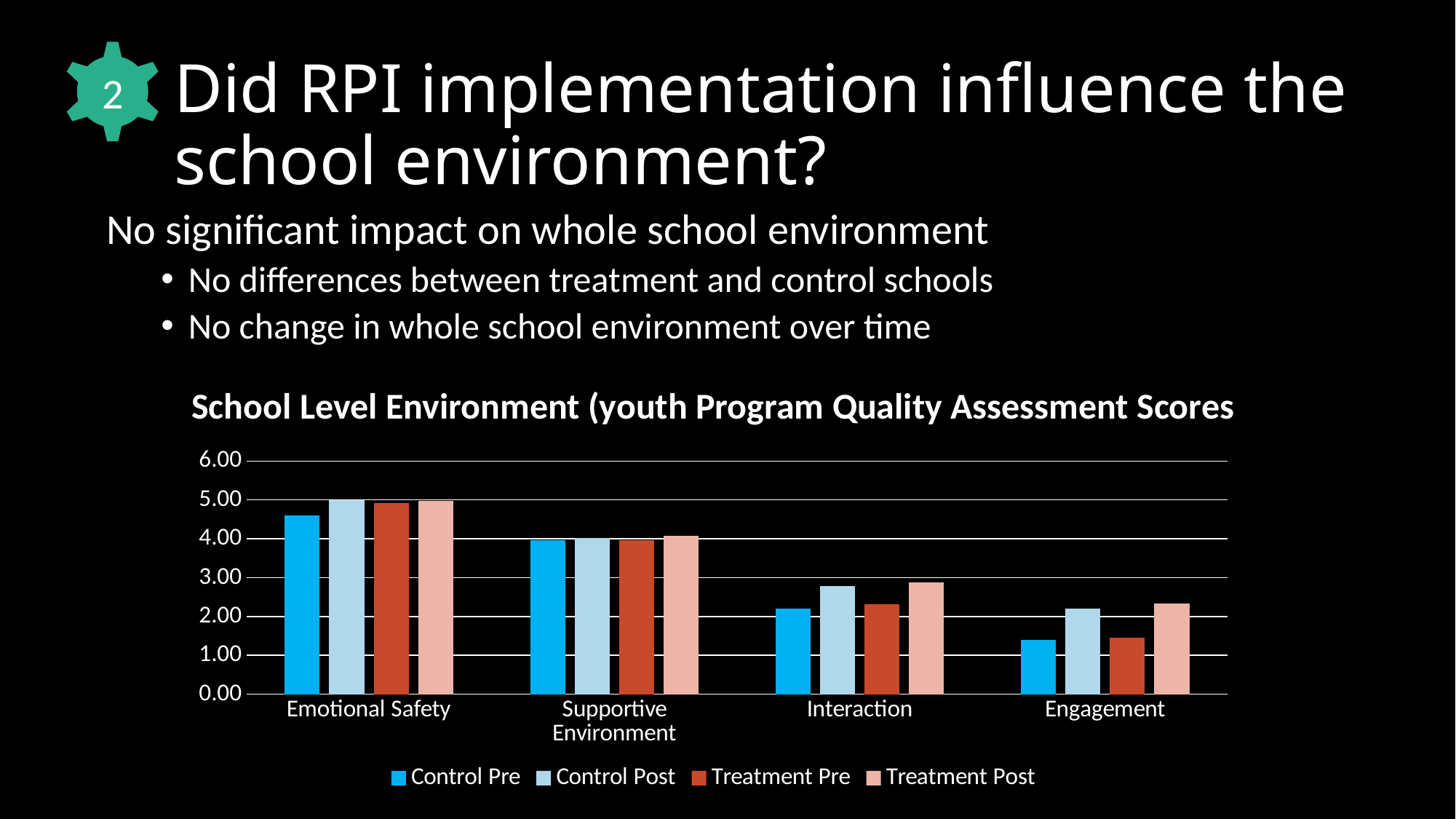
How many categories are shown on the x axis of the chart? 4 Do the Control Pre values rise or fall moving from Emotional Safety to Engagement along the x axis? fall Is the Control Pre value for Engagement greater or less than 2.00? less Is the Control Pre value for Emotional Safety greater or less than 4.00? greater For Interaction, which is larger: the Control Pre value or the Control Post value? Control Post How many series does the chart's legend list? 4 Which series is shown in the darkest red-orange colour in the legend? Treatment Pre Which category has the highest Control Pre value? Emotional Safety What is the title of the chart? School Level Environment (youth Program Quality Assessment Scores What kind of chart is shown on the slide? bar chart Is the Treatment Post value for Interaction greater or less than 2.00? greater Which category has the lowest Control Pre value? Engagement